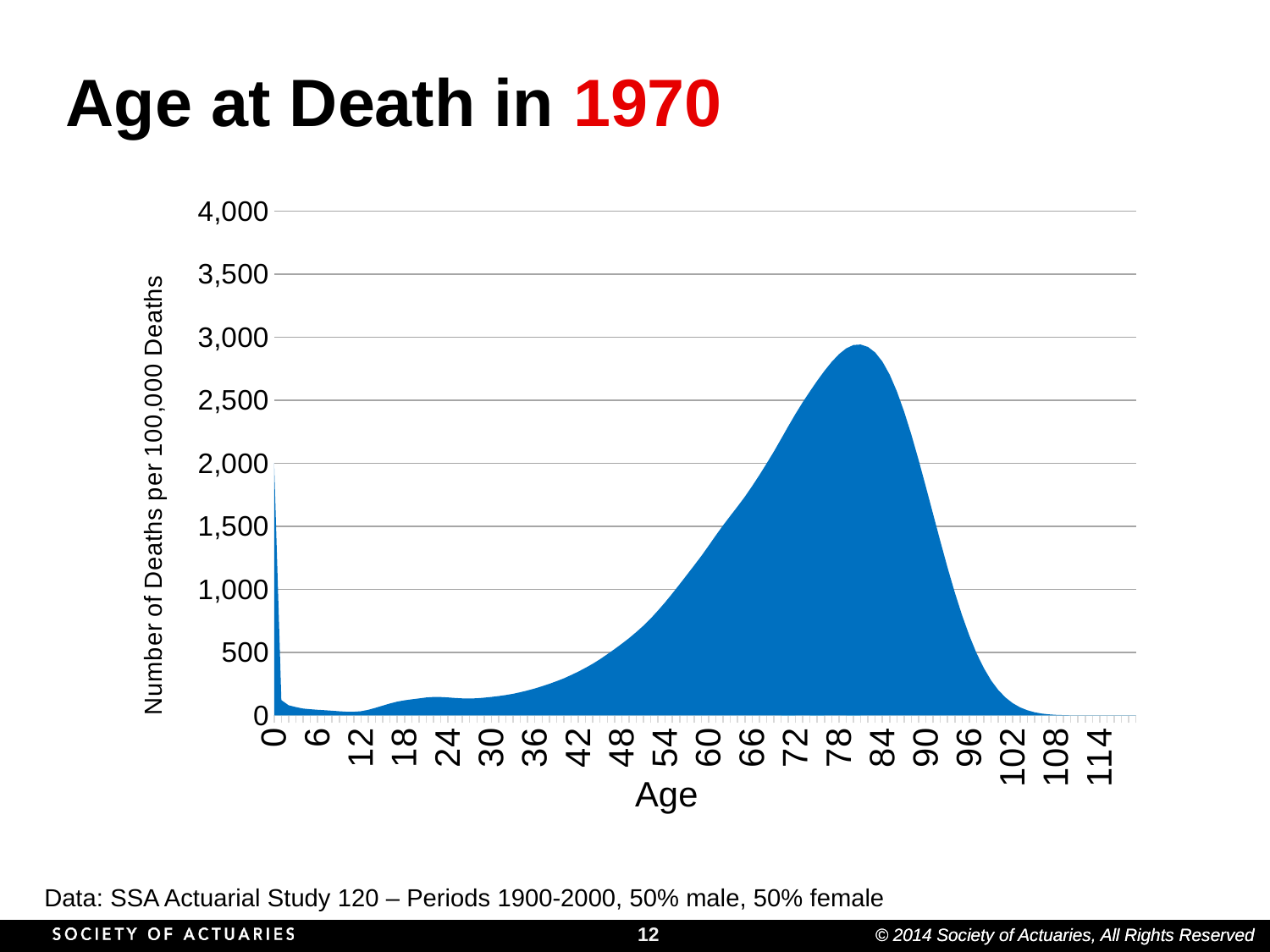
Is the value for age 0 greater or less than 1,500? greater Is the value for age 72 greater or less than 2,000? greater Is the value for age 108 greater or less than 500? less What is the label of the vertical axis? Number of Deaths per 100,000 Deaths Which has the larger value, age 78 or age 24? Age 78 Do the values rise or fall as age increases from 36 to 78? Rise What kind of chart is shown on the slide? Area chart Do the values rise or fall as age increases from 84 to 108? Fall What is the title of the chart on the slide? Age at Death in 1970